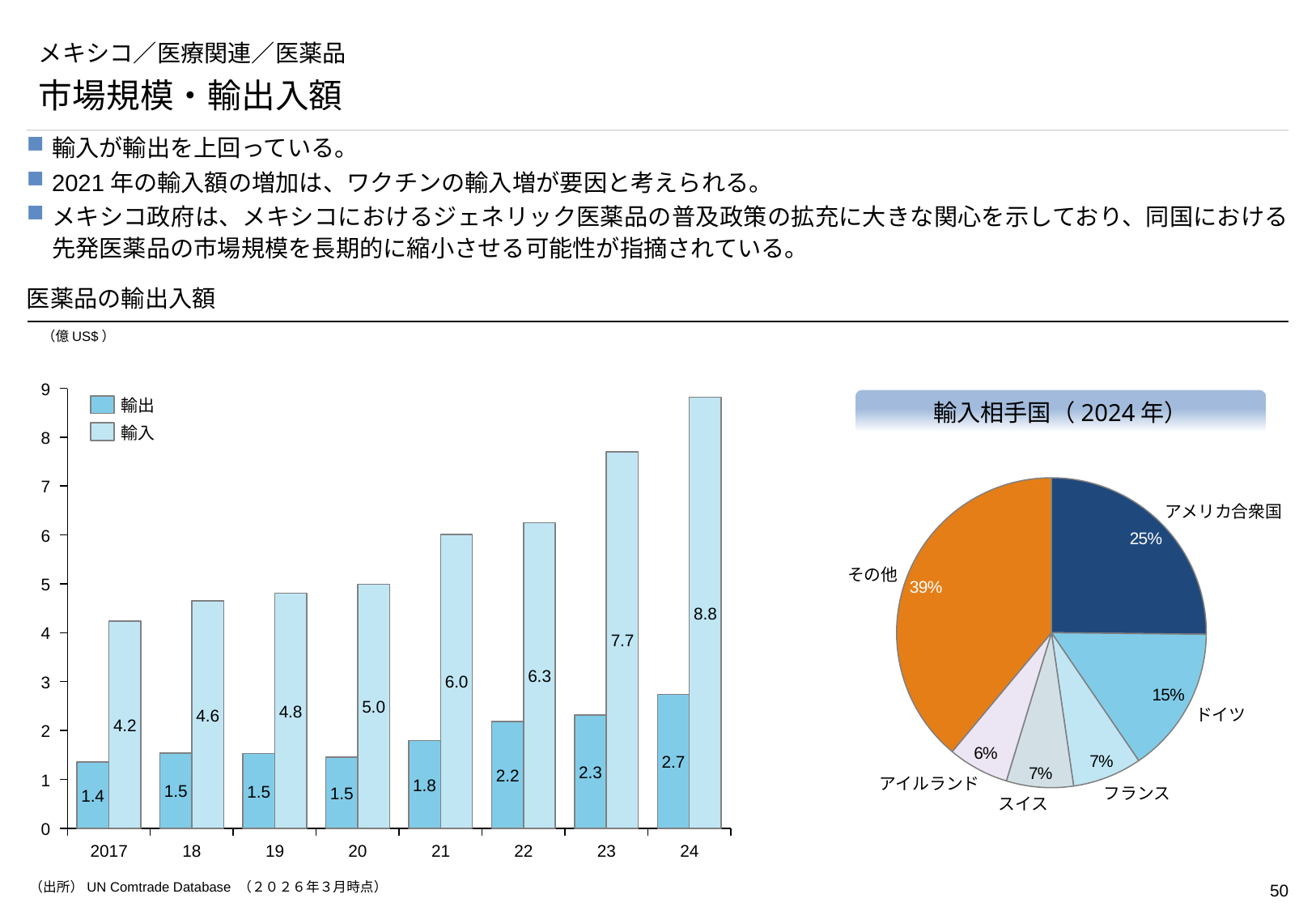
What kind of chart is 医薬品の輸出入額? bar chart In the bar chart 医薬品の輸出入額, is the 輸入 value for 2023 greater or less than 7? greater In the pie chart 輸入相手国（2024年）, what share does ドイツ have? 15% In the bar chart 医薬品の輸出入額, what is the difference between the 輸入 and 輸出 values for 2024? 6.1 In the bar chart 医薬品の輸出入額, does the 輸入 value rise or fall from 2017 to 24? rise In the pie chart 輸入相手国（2024年）, which slice is the largest? その他 In the bar chart 医薬品の輸出入額, what is the 輸出 value for 2024? 2.7 In the bar chart 医薬品の輸出入額, which year has the lowest 輸出 value? 2017 In the bar chart 医薬品の輸出入額, how many series does the legend list? 2 In the pie chart 輸入相手国（2024年）, how many slices are there? 6 In the bar chart 医薬品の輸出入額, what is the 輸入 value for 2021? 6.0 In the bar chart 医薬品の輸出入額, which year has the highest 輸入 value? 24